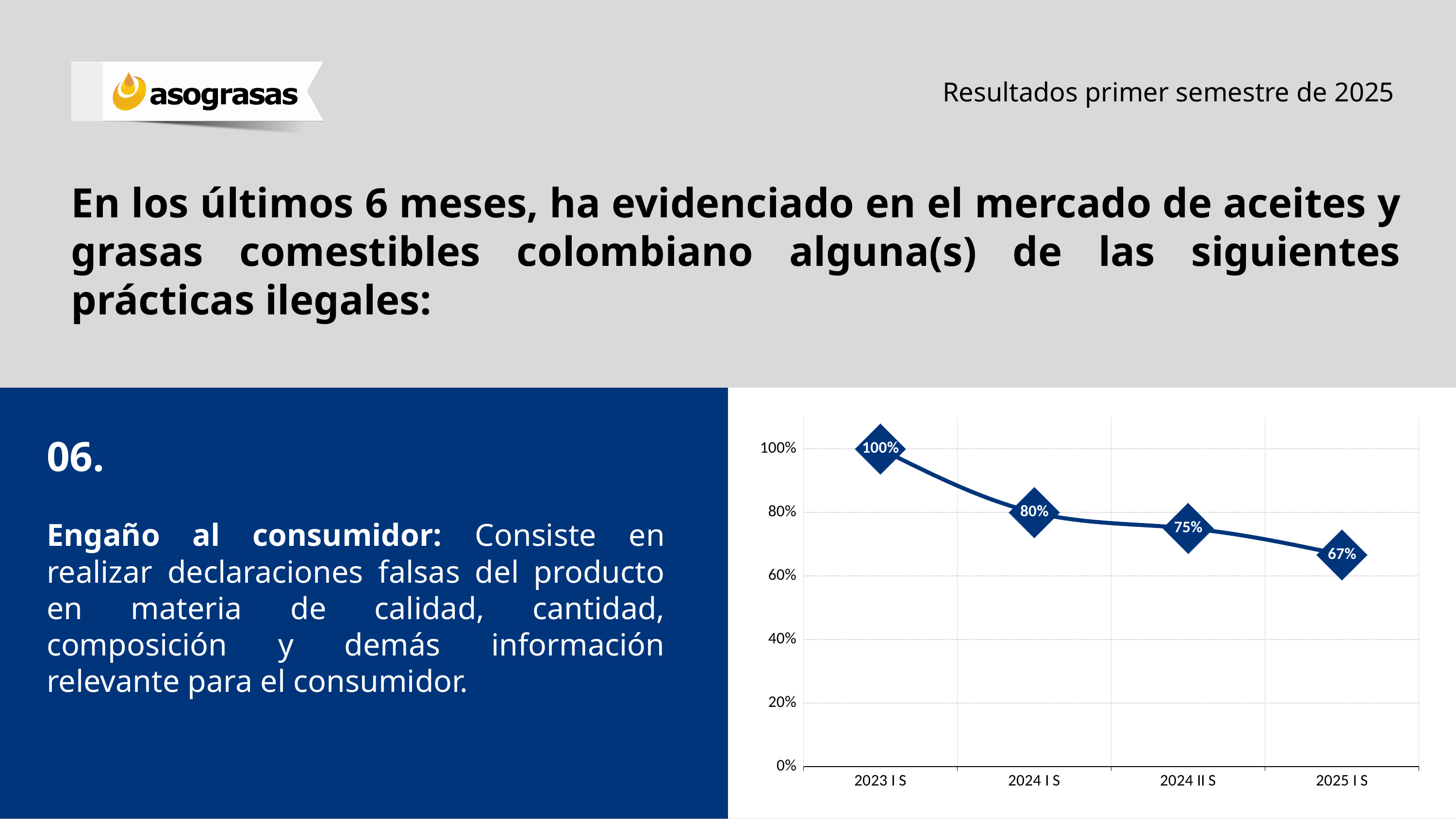
What is the difference between the values for 2023 I S and 2025 I S? 33% Which period has the lowest value? 2025 I S Do the values rise or fall from 2023 I S to 2025 I S? Fall What is the difference between the values for 2024 I S and 2024 II S? 5% What is the value for 2025 I S? 67% What is the value for 2024 I S? 80% Which is larger, the value for 2024 I S or the value for 2025 I S? 2024 I S What is the value for 2024 II S? 75% Which period has the highest value? 2023 I S What kind of chart is shown on the slide? Line chart How many data points are plotted on the chart? 4 What is the value for 2023 I S? 100%